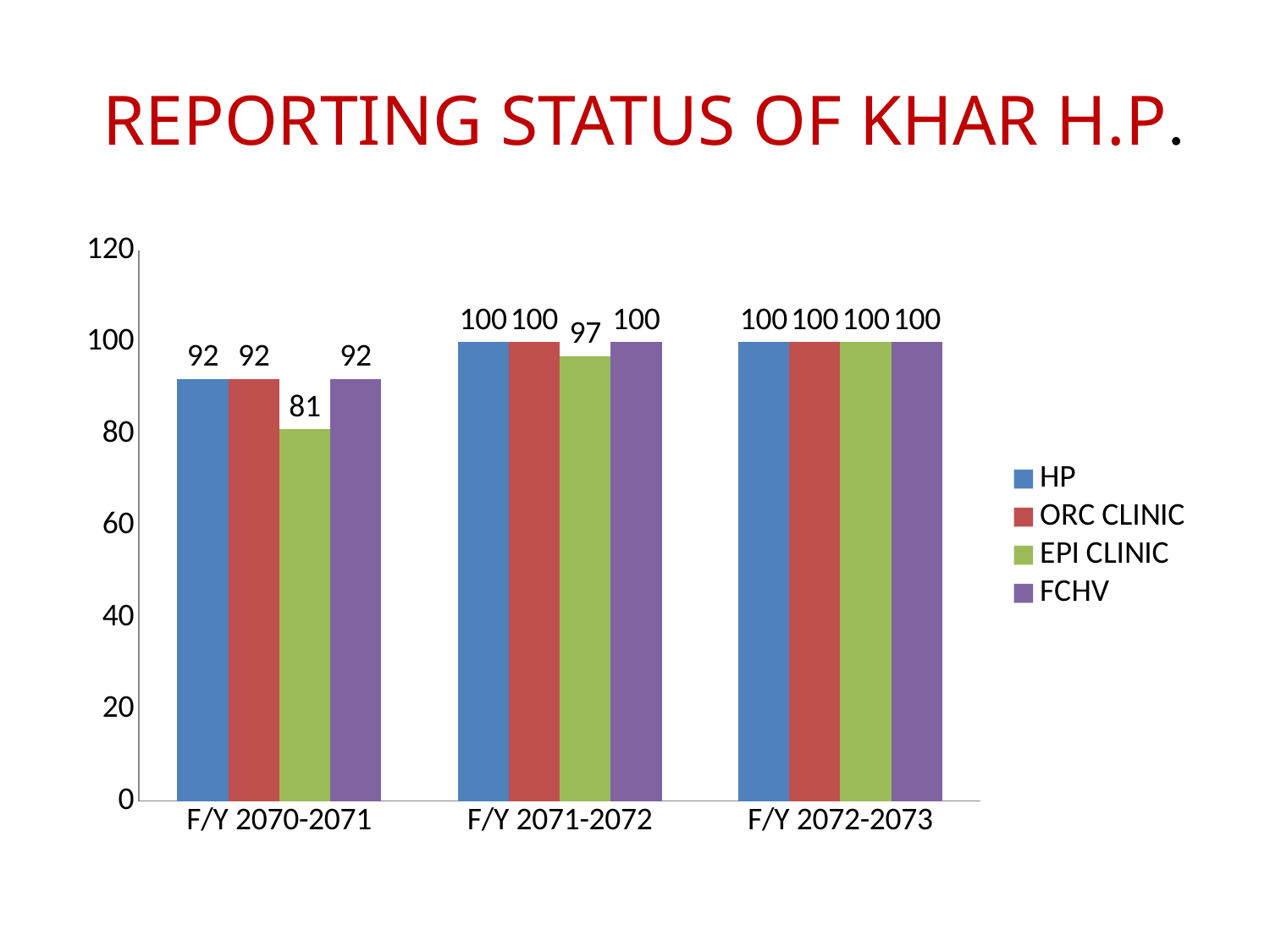
What is the value for HP in F/Y 2070-2071? 92 What is the value for EPI CLINIC in F/Y 2070-2071? 81 What is the difference between the EPI CLINIC value in F/Y 2071-2072 and in F/Y 2070-2071? 16 How many series does the legend list? 4 Which series has the lowest value in F/Y 2070-2071? EPI CLINIC Which series has the lowest value in F/Y 2071-2072? EPI CLINIC What is the difference between the HP value and the EPI CLINIC value in F/Y 2070-2071? 11 What is the value for FCHV in F/Y 2072-2073? 100 What is the value for EPI CLINIC in F/Y 2071-2072? 97 Which is larger, the EPI CLINIC value in F/Y 2070-2071 or in F/Y 2072-2073? F/Y 2072-2073 Does the EPI CLINIC value rise or fall from F/Y 2070-2071 to F/Y 2072-2073? rise How many fiscal year categories are shown on the x axis? 3